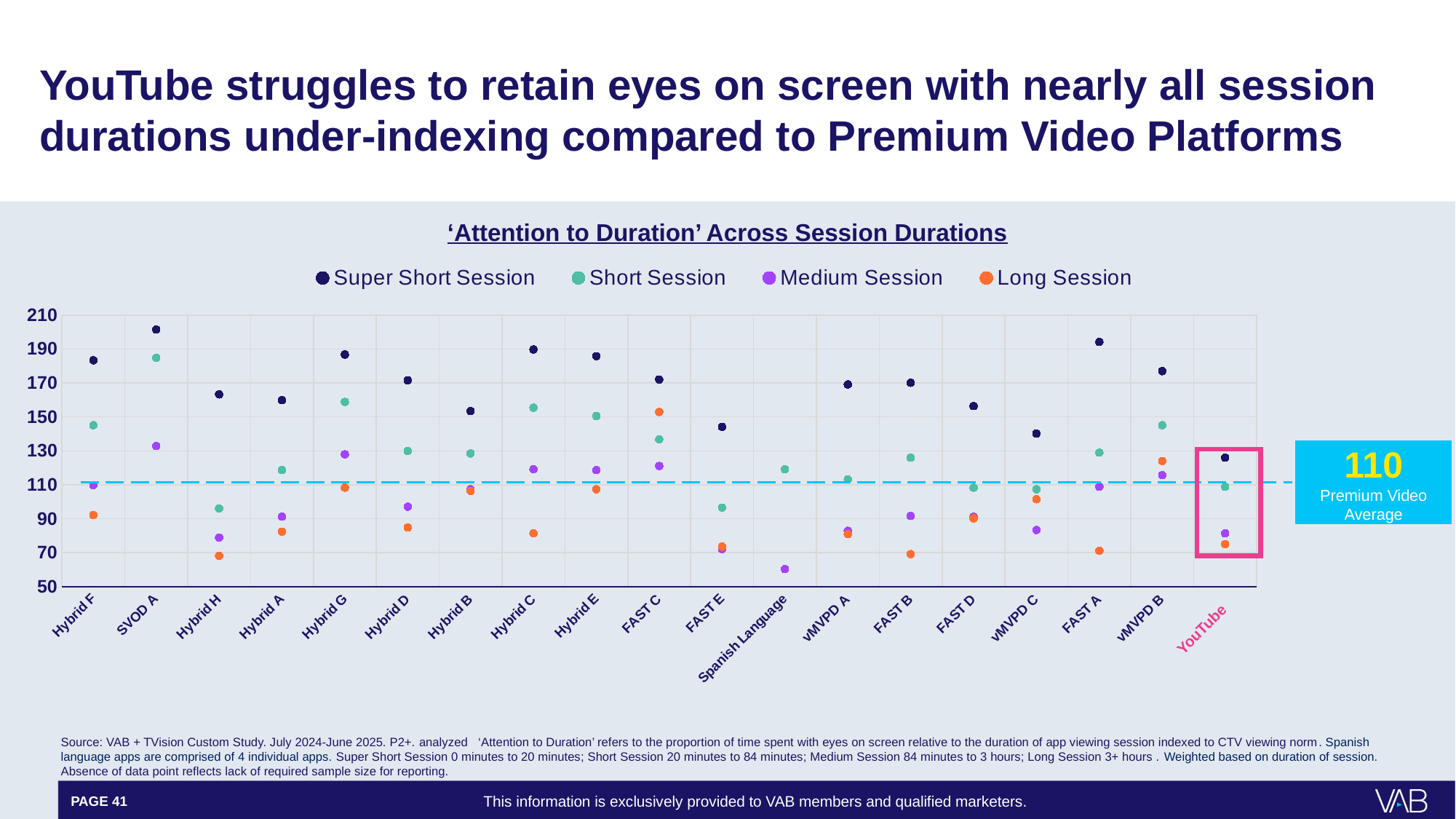
For YouTube, which is larger: the Super Short Session value or the Long Session value? Super Short Session Which platform has the highest Super Short Session value? SVOD A Is the Medium Session value for Spanish Language greater or less than 70? less Which platform has the lowest Medium Session value? Spanish Language What value is shown for the Premium Video Average on the chart? 110 Is the Long Session value for YouTube greater or less than 90? less Is the Long Session value for FAST C greater or less than 130? greater How many series does the legend list? 4 How many platforms (categories) are plotted along the x axis? 19 Which platform is highlighted with a pink box on the chart? YouTube What kind of chart is shown on the slide? Scatter (dot) chart